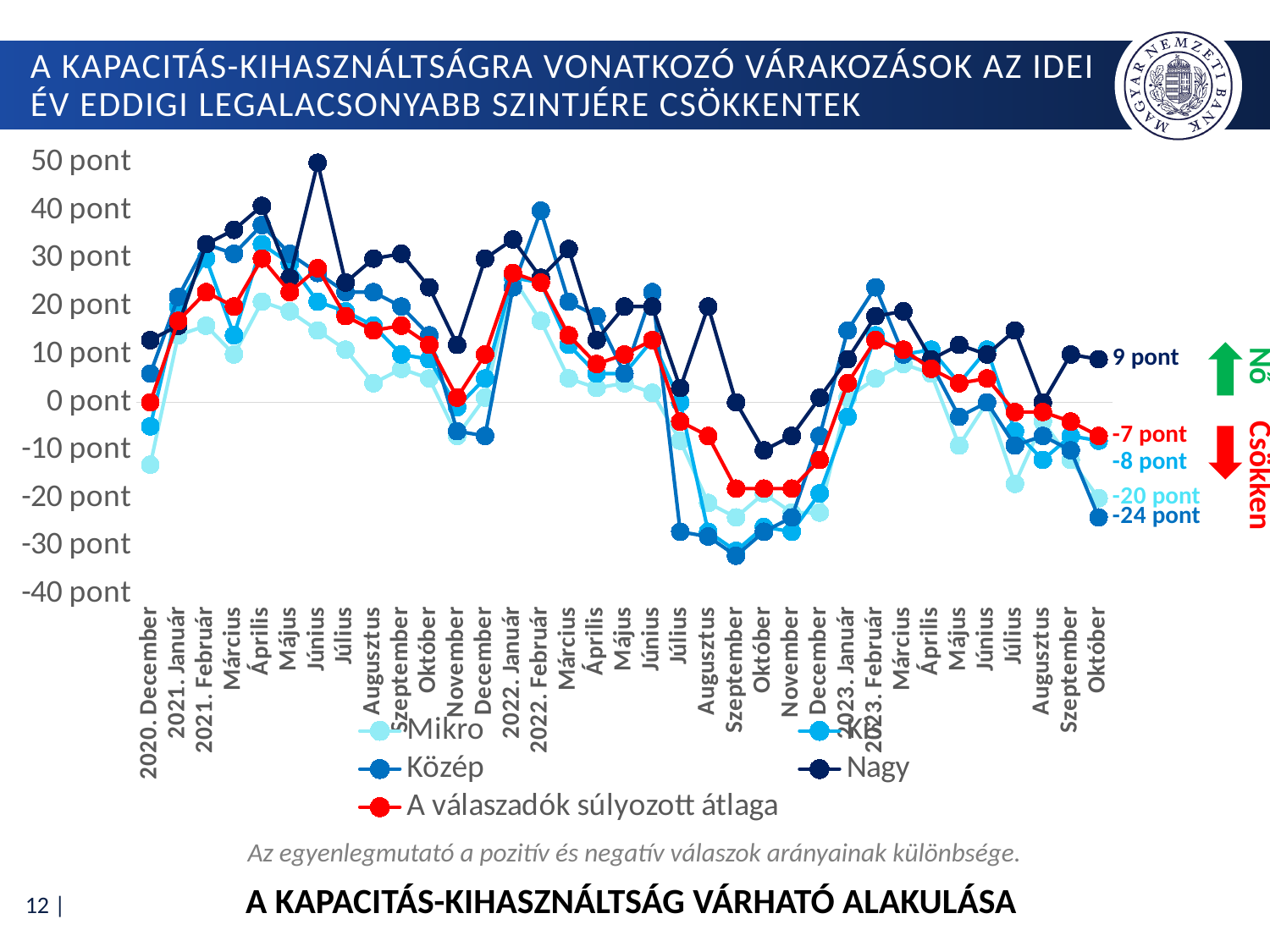
What is the title of the chart? A kapacitás-kihasználtság várható alakulása What is the value for the Nagy series in 2023 Október? 9 pont What is the value for 'A válaszadók súlyozott átlaga' in 2023 Október? -7 pont What kind of chart is shown on the slide? line chart Which series has the lowest value in 2023 Október? Közép What is the value for the Mikro series in 2023 Október? -20 pont How many series does the legend list? 5 What is the difference between the Nagy and Közép values in 2023 Október? 33 pont What is the value for the Közép series in 2023 Október? -24 pont Is the value for the Nagy series in 2021 Június greater or less than 40 pont? greater Which series has the highest value in 2023 Október? Nagy